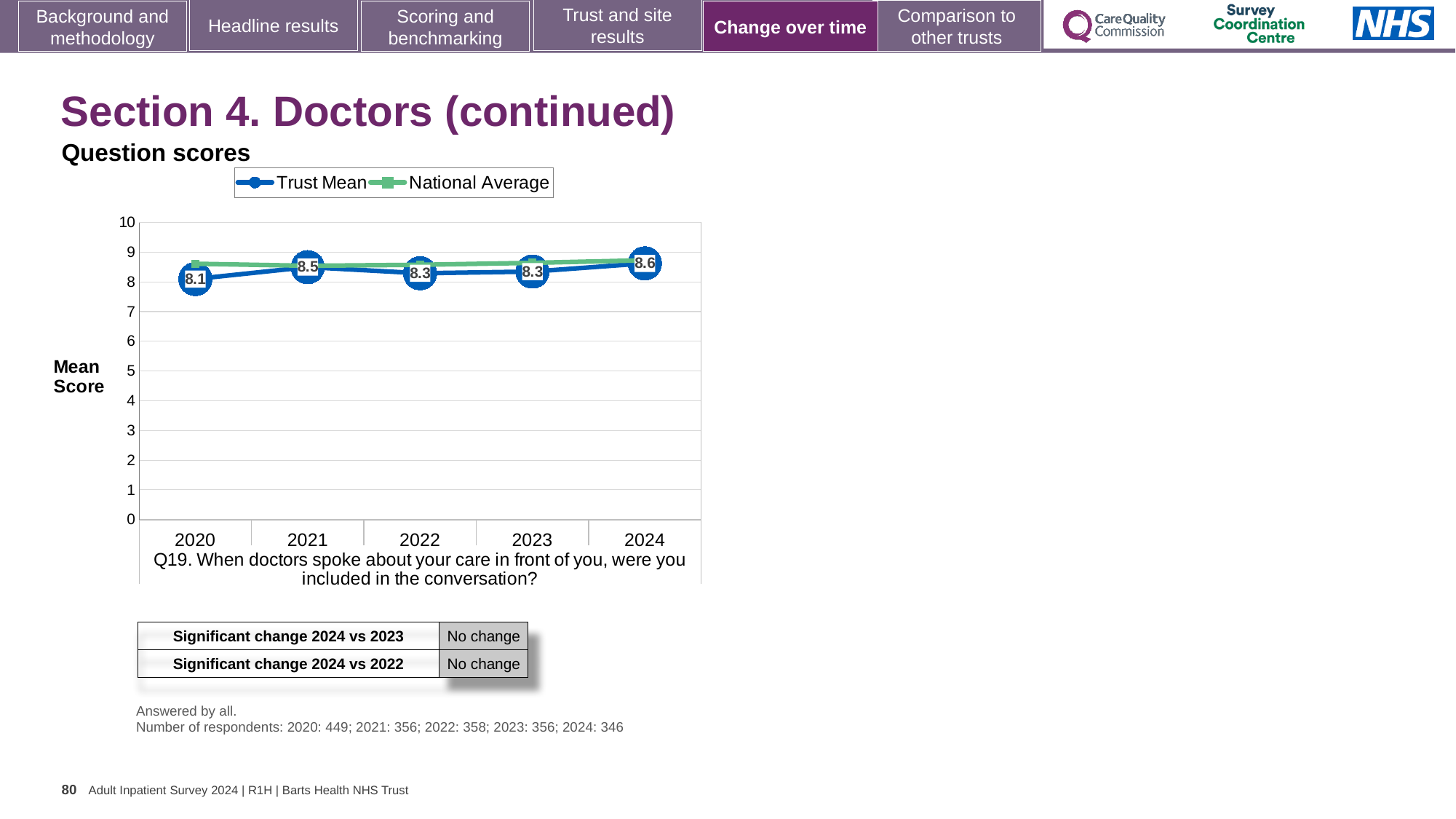
What is the Trust Mean score for 2024? 8.6 In which year is the Trust Mean score highest? 2024 What is the Trust Mean score for 2020? 8.1 How many series does the legend list? 2 Which question does the chart show scores for? Q19. When doctors spoke about your care in front of you, were you included in the conversation? Is the National Average value for 2020 greater or less than 8? greater How many years are shown on the x axis? 5 What is the difference between the Trust Mean score in 2024 and in 2020? 0.5 In which year is the Trust Mean score lowest? 2020 What is the Trust Mean score for 2021? 8.5 What kind of chart is shown? Line chart Which is larger, the Trust Mean score in 2021 or in 2022? 2021